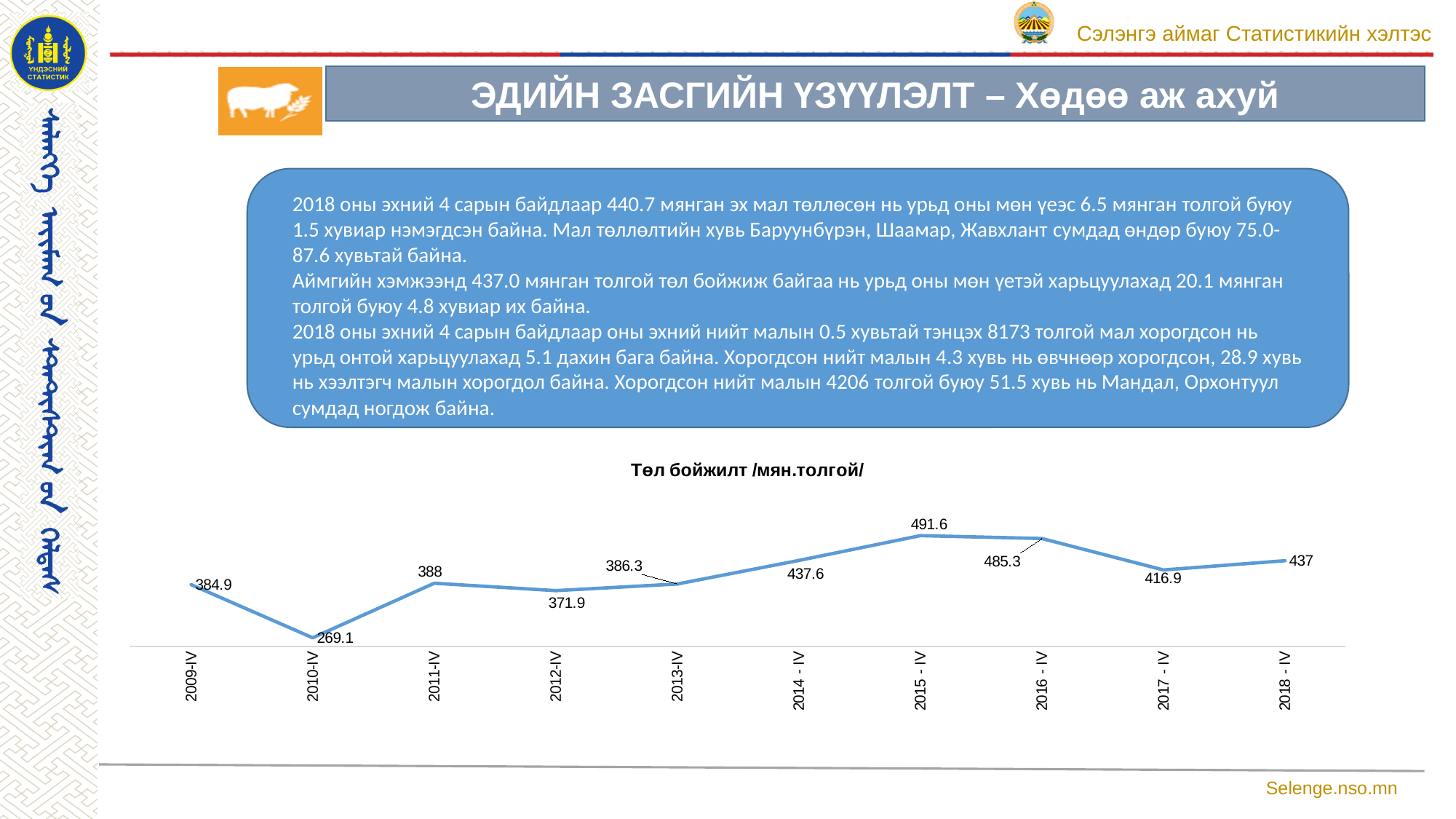
What is the difference between the values for 2015 - IV and 2016 - IV? 6.3 What is the value for 2015 - IV? 491.6 What type of chart is shown on the slide? line chart What is the difference between the values for 2018 - IV and 2017 - IV? 20.1 What is the title of the chart? Төл бойжилт /мян.толгой/ How many data points are plotted on the chart? 10 What is the value for 2018 - IV? 437 Which is larger, the value for 2011-IV or the value for 2012-IV? 2011-IV Which period has the lowest value? 2010-IV Does the value rise or fall from 2013-IV to 2015 - IV? rise Which period has the highest value? 2015 - IV What is the value for 2010-IV? 269.1